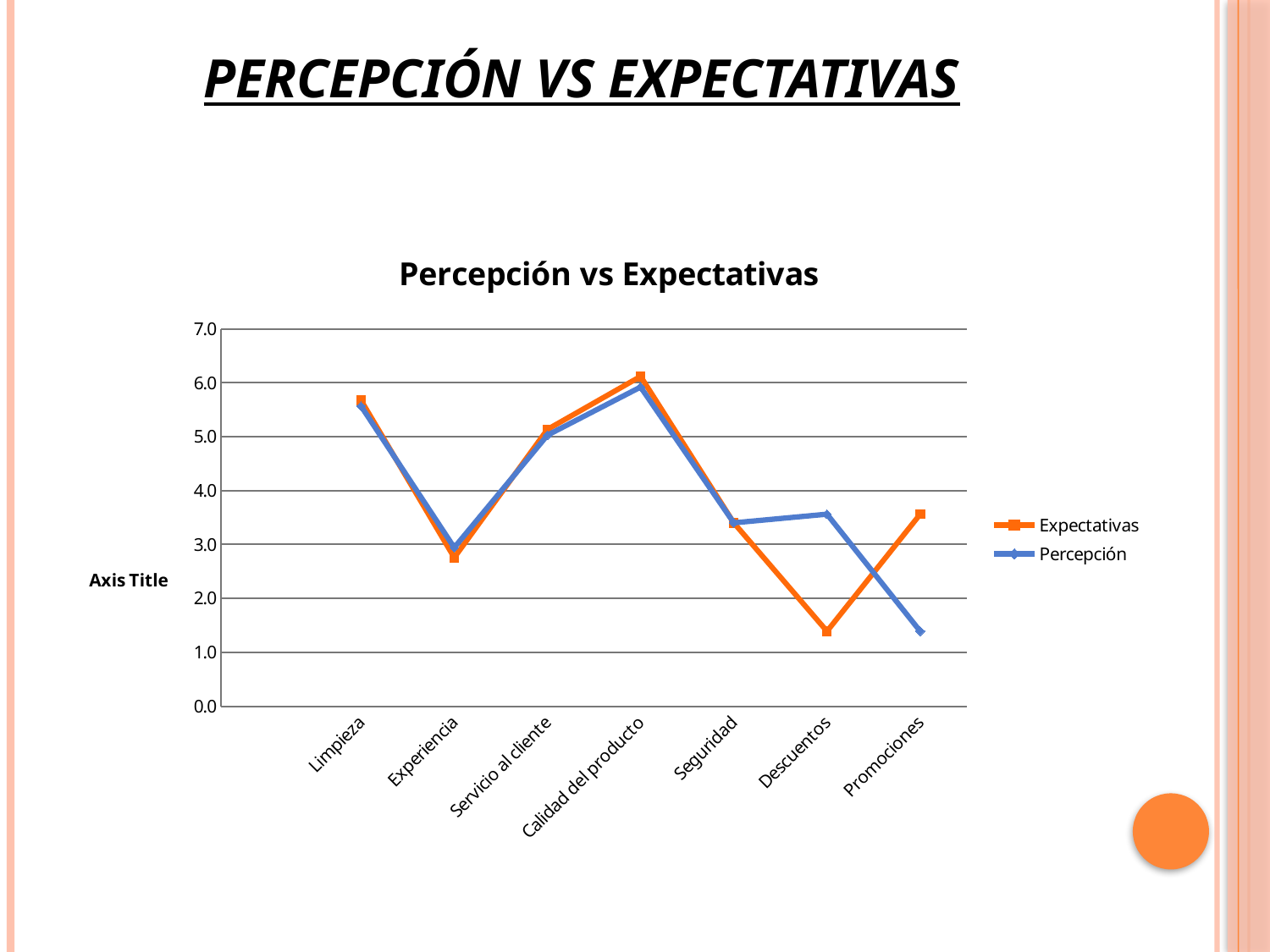
For Promociones, which series has the larger value, Expectativas or Percepción? Expectativas Is the Expectativas value for Descuentos greater or less than 2.0? less Which series is drawn in orange? Expectativas Which category has the highest value for Percepción? Calidad del producto For Descuentos, which series has the larger value, Expectativas or Percepción? Percepción Which category has the highest value for Expectativas? Calidad del producto What kind of chart is shown on the slide? line chart Which category has the lowest value for Expectativas? Descuentos How many series does the legend list? 2 Is the Percepción value for Limpieza greater or less than 5.0? greater How many categories are shown on the x axis? 7 Which category has the lowest value for Percepción? Promociones